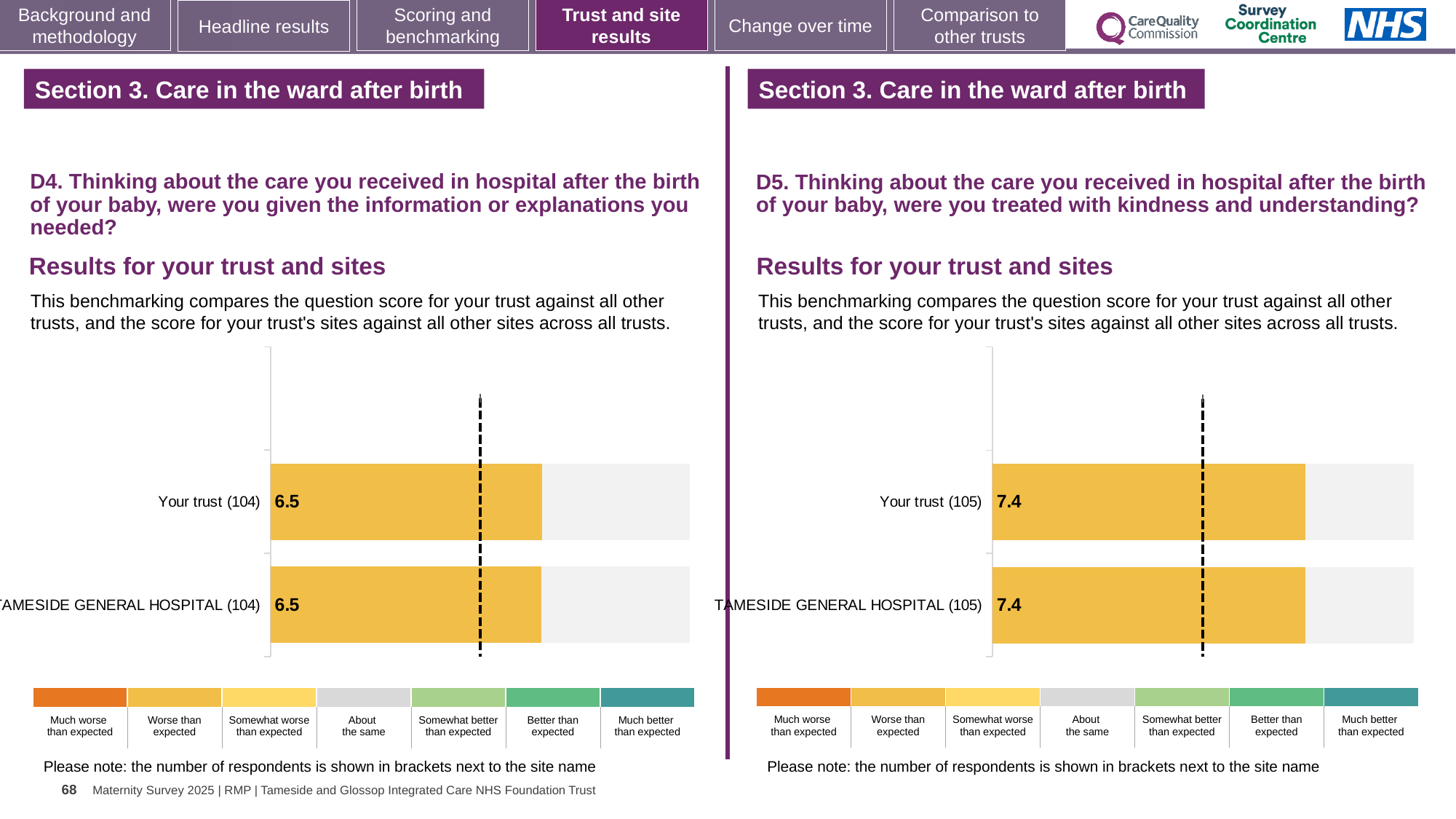
On the left chart (D4), what is the score for Your trust? 6.5 On the left chart (D4), how many respondents are shown in brackets next to Tameside General Hospital? 104 On the right chart (D5), how many respondents are shown in brackets next to Your trust? 105 On the left chart (D4), what is the difference between the score for Your trust and the score for Tameside General Hospital? 0 How many bars are plotted on the right chart (D5)? 2 On the right chart (D5), what is the score for Tameside General Hospital? 7.4 How many categories does the colour key below the left chart (D4) list? 7 What kind of chart is used on the left (D4)? Bar chart Which is larger: the Your trust score on the left chart (D4) or the Your trust score on the right chart (D5)? The right chart (D5), 7.4 On the right chart (D5), what is the score for Your trust? 7.4 On the left chart (D4), what is the score for Tameside General Hospital? 6.5 How many bars are plotted on the left chart (D4)? 2